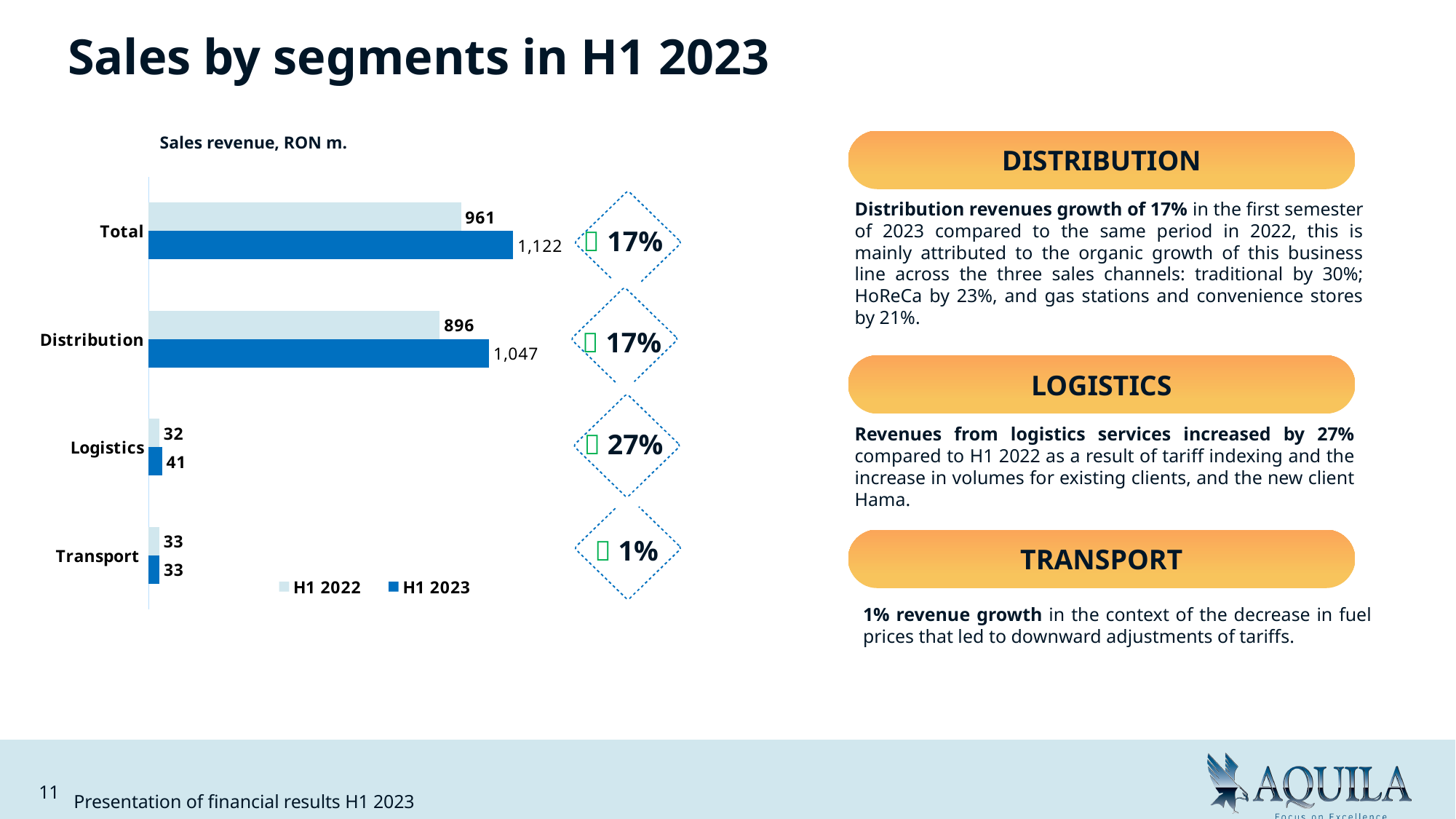
What is the difference between the H1 2023 and H1 2022 values for Distribution? 151 What is the H1 2022 value for Transport? 33 Is the H1 2023 value for Logistics larger or smaller than the H1 2023 value for Transport? larger Which segment (excluding Total) has the lowest H1 2023 sales revenue? Transport What is the H1 2023 sales revenue for Distribution? 1,047 What kind of chart is shown on the slide? bar chart What is the H1 2023 value for Total? 1,122 How many series does the legend list? 2 How many categories are shown on the chart? 4 What is the difference between the H1 2023 and H1 2022 values for Logistics? 9 Which category has the highest H1 2023 value? Total What is the H1 2022 sales revenue for Logistics? 32